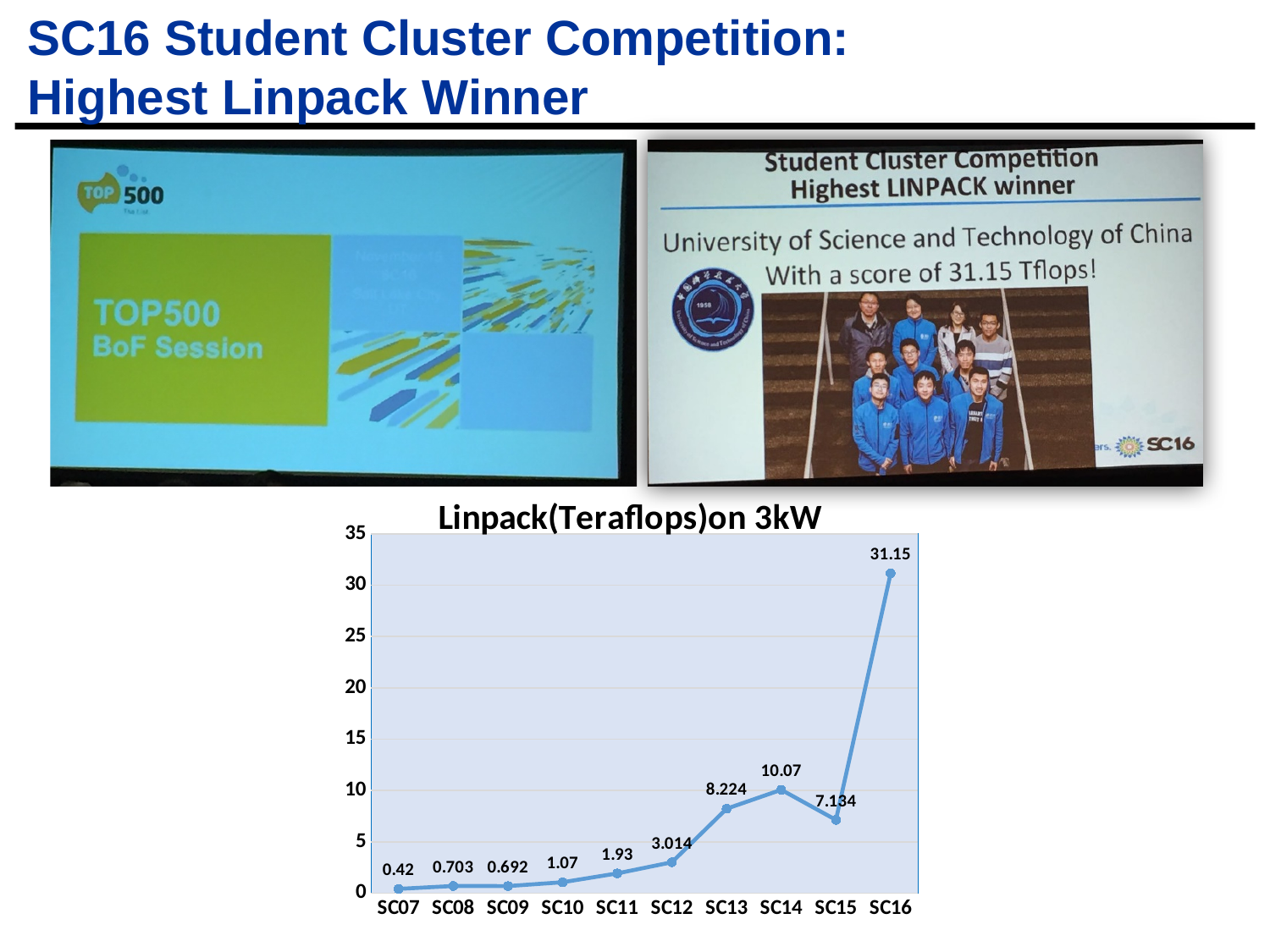
Which year has the lowest Linpack value? SC07 Which year has the highest Linpack value? SC16 What is the Linpack value for SC13? 8.224 What is the difference between the Linpack values for SC16 and SC15? 24.016 Which is larger, the Linpack value for SC14 or SC15? SC14 What is the Linpack value for SC07? 0.42 What is the Linpack value for SC16? 31.15 What kind of chart is shown on the slide? line chart What is the title of the chart? Linpack(Teraflops)on 3kW Does the Linpack value rise or fall from SC14 to SC15? fall How many data points are plotted on the chart? 10 Is the value for SC14 greater or less than 5? greater